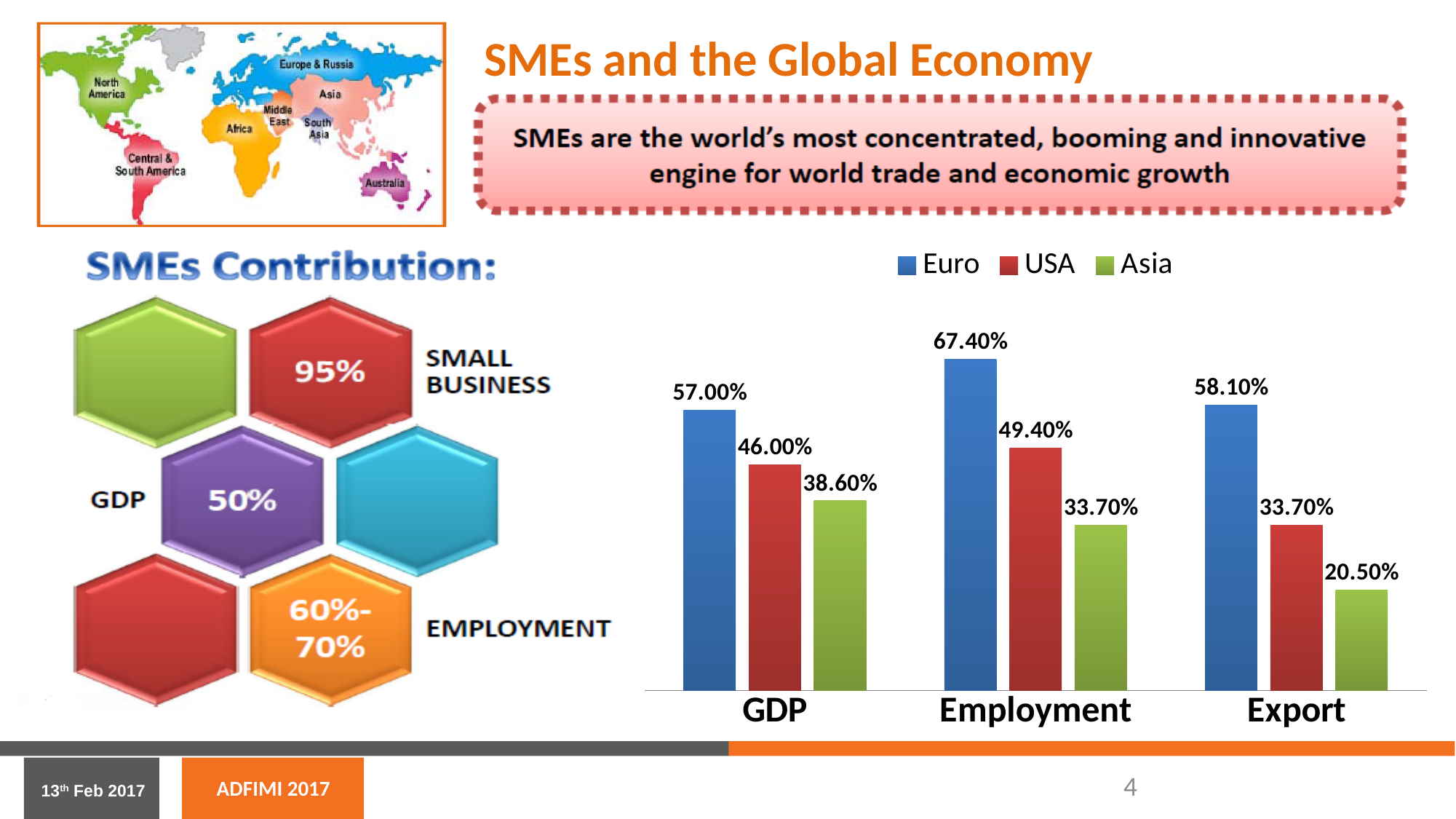
Which category has the lowest Asia value in the bar chart? Export How many series does the legend of the bar chart list? 3 What is the USA value for Employment in the bar chart? 49.40% What kind of chart is shown on the right side of the slide? Bar chart How many categories are shown on the x axis of the bar chart? 3 Which series is shown in green in the bar chart? Asia What is the difference between the Euro and Asia values for Export in the bar chart? 37.60% Which category has the highest Euro value in the bar chart? Employment What is the difference between the Euro and USA values for GDP in the bar chart? 11.00% What is the Asia value for Export in the bar chart? 20.50% What is the Euro value for GDP in the bar chart? 57.00% In the bar chart, which is larger: the USA value for GDP or the USA value for Export? USA value for GDP